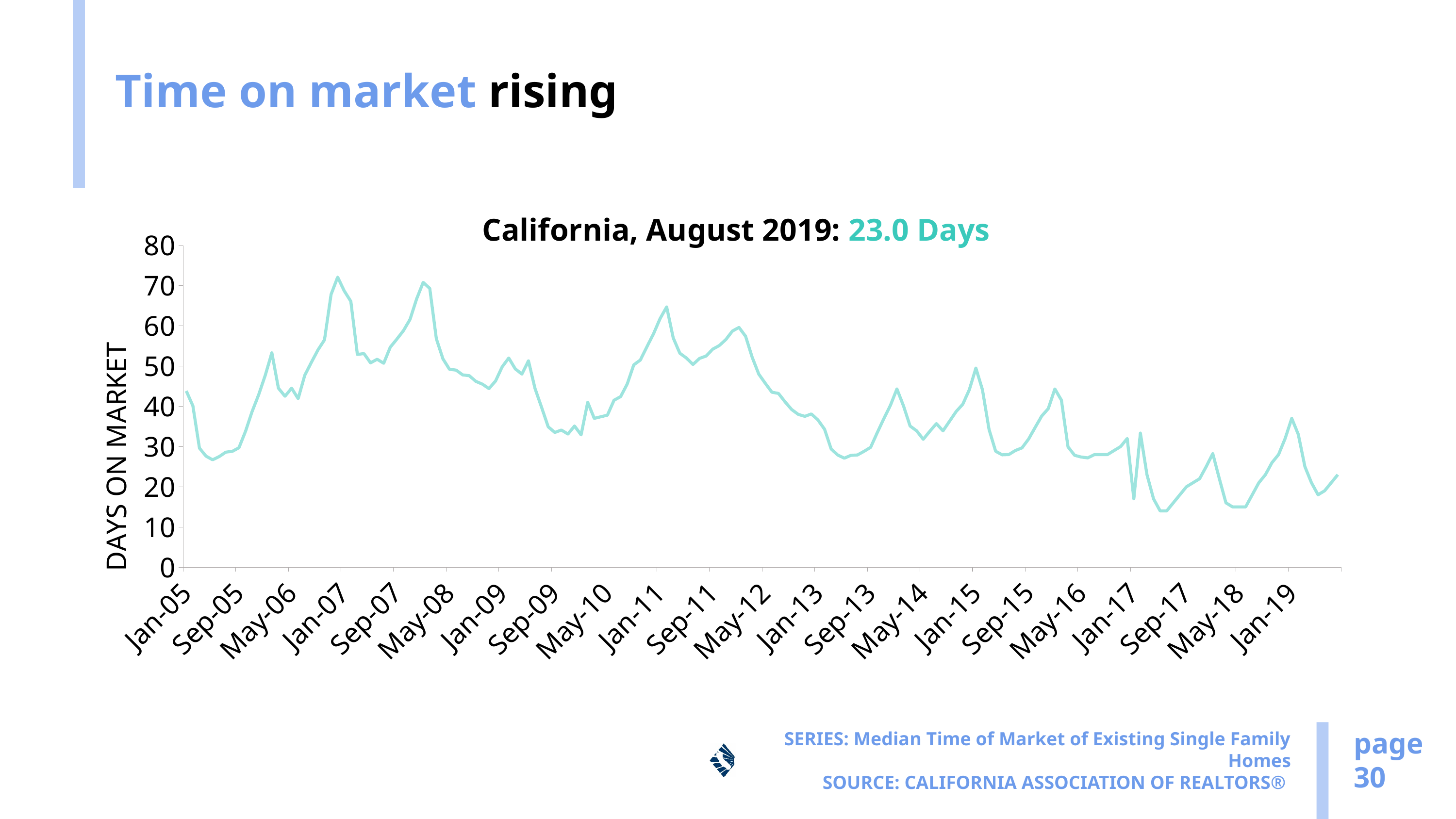
Is the value for Jan-05 greater or less than 30? greater Is the value for Jan-07 greater or less than 60? greater What is the median days on market for California in August 2019, as stated in the chart title? 23.0 Days Overall, do the days on market values rise or fall from Jan-05 to 2019? fall What kind of chart is shown on the slide? line chart What is the label on the vertical axis of the chart? DAYS ON MARKET Is the value for Sep-09 greater or less than 40? less What is the title of the chart? California, August 2019: 23.0 Days How many lines (data series) are plotted on the chart? 1